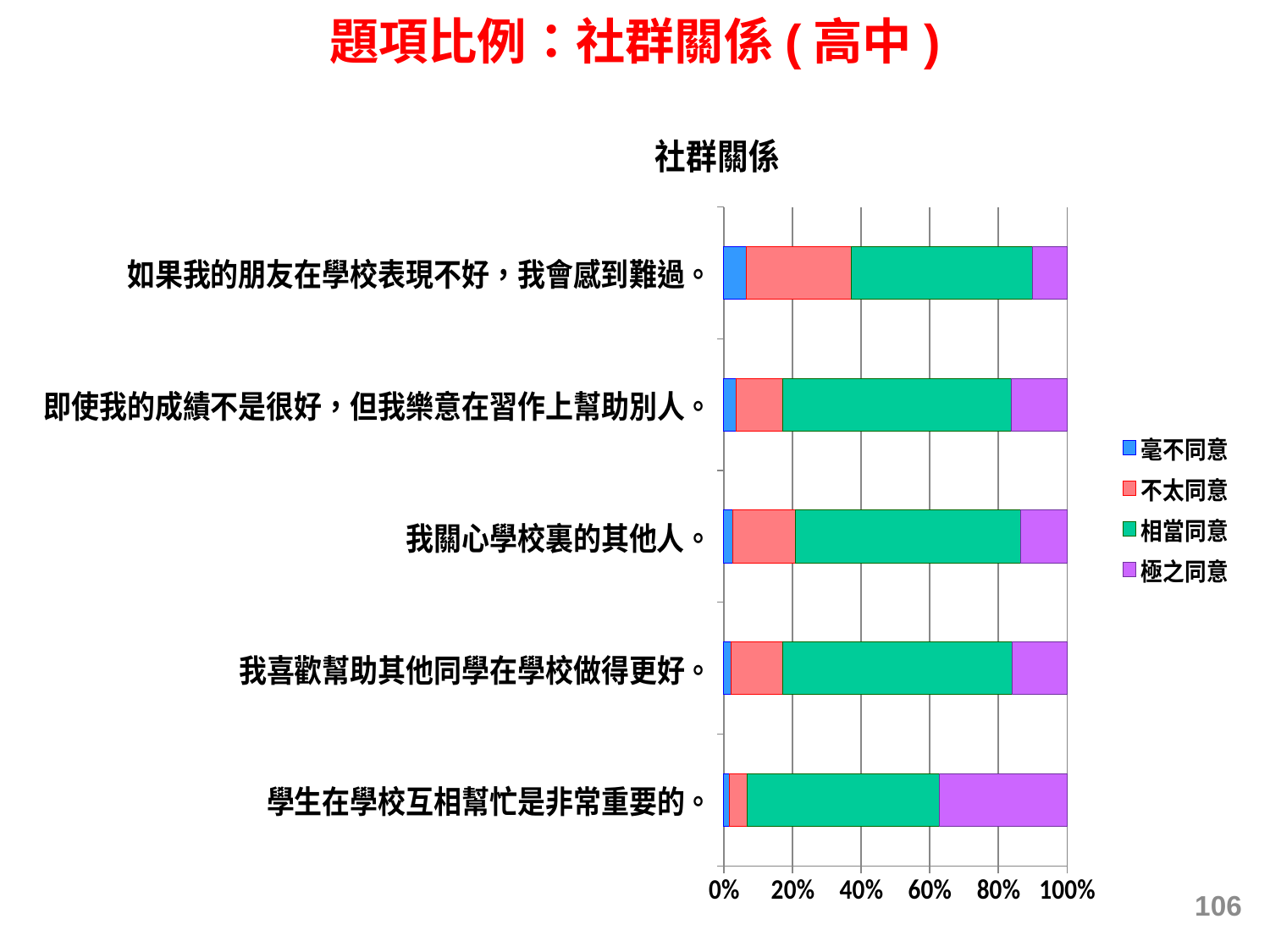
Which statement has a larger 不太同意 segment: 「如果我的朋友在學校表現不好，我會感到難過。」 or 「學生在學校互相幫忙是非常重要的。」? 如果我的朋友在學校表現不好，我會感到難過。 Is the 極之同意 share for 「學生在學校互相幫忙是非常重要的。」 greater or less than 20%? greater Which statement has the largest 極之同意 segment? 學生在學校互相幫忙是非常重要的。 What kind of chart is shown on the slide? stacked bar chart How many statements (categories) are plotted in the chart? 5 What is the title of the chart? 社群關係 How many series does the legend list? 4 Which legend entry is shown in green? 相當同意 What is the total of each stacked bar in the chart? 100% Is the 不太同意 share for 「如果我的朋友在學校表現不好，我會感到難過。」 greater or less than 20%? greater Is the 相當同意 share for 「學生在學校互相幫忙是非常重要的。」 greater or less than 40%? greater Which statement has the smallest 不太同意 segment? 學生在學校互相幫忙是非常重要的。